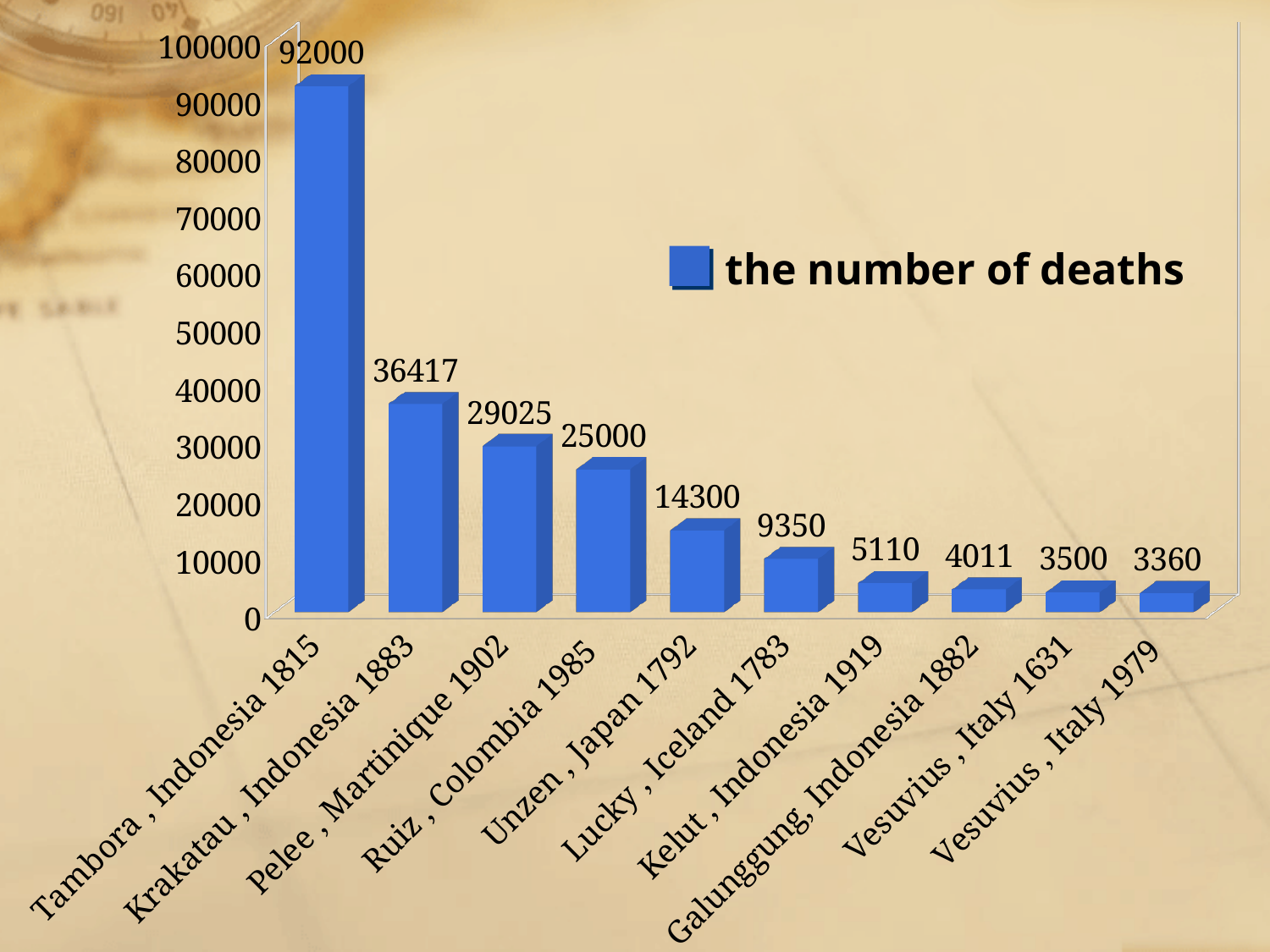
How many eruptions are shown on the chart? 10 What is the difference in the number of deaths between Krakatau, Indonesia 1883 and Ruiz, Colombia 1985? 11417 What is the number of deaths for Tambora, Indonesia 1815? 92000 Which eruption has the lowest number of deaths? Vesuvius, Italy 1979 How many series does the legend list? 1 Which has more deaths, Unzen, Japan 1792 or Kelut, Indonesia 1919? Unzen, Japan 1792 What kind of chart is shown on the slide? bar chart What is the number of deaths for Pelee, Martinique 1902? 29025 What is the legend entry for the series shown? the number of deaths What is the number of deaths for Lucky, Iceland 1783? 9350 Is the number of deaths for Galunggung, Indonesia 1882 greater or less than 10000? less Which eruption has the highest number of deaths? Tambora, Indonesia 1815